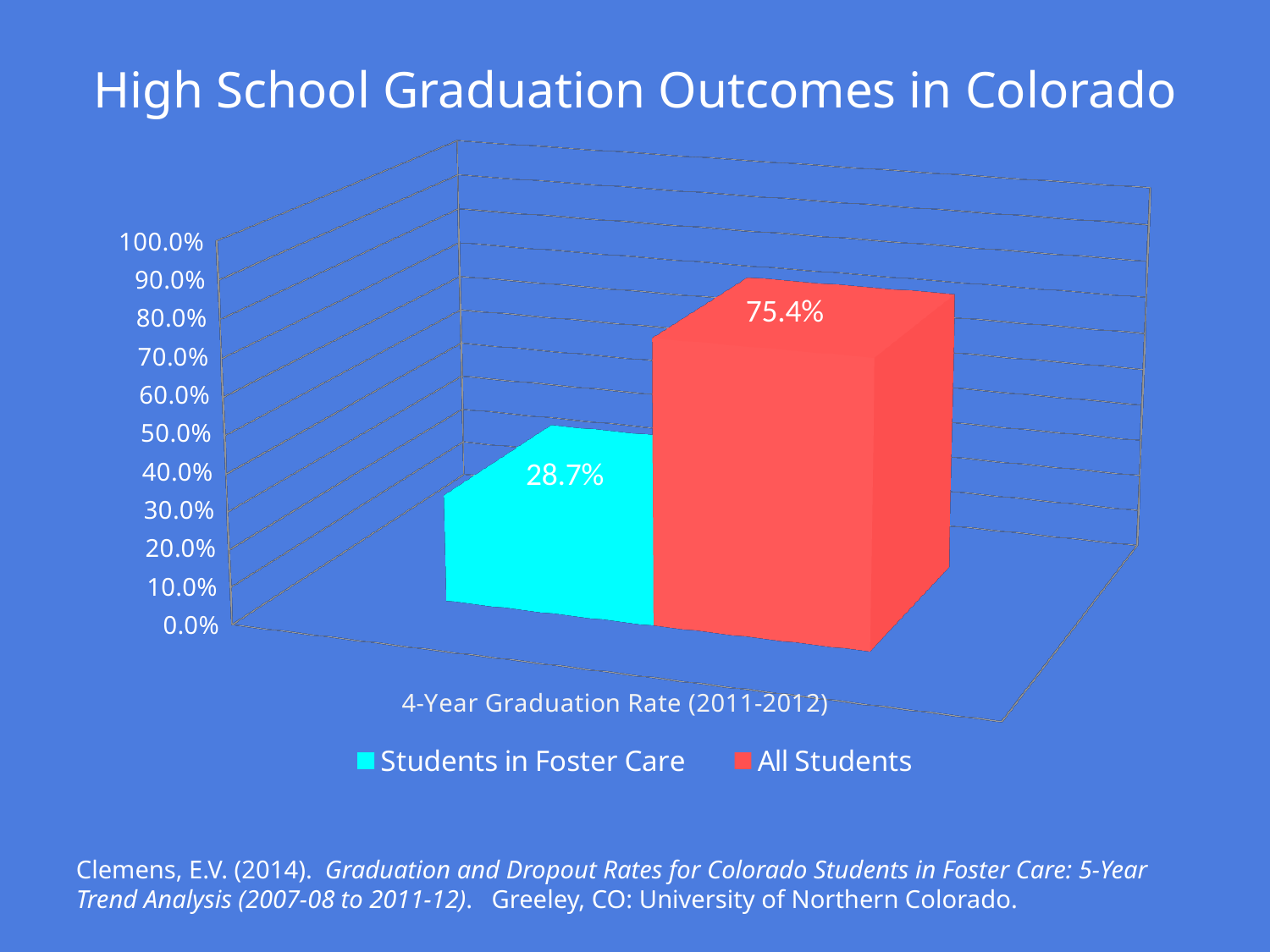
What is the 4-Year Graduation Rate (2011-2012) for Students in Foster Care? 28.7% Which series has the lowest graduation rate shown? Students in Foster Care What is the difference in percentage points between the graduation rate for All Students and for Students in Foster Care? 46.7 percentage points How many series does the legend list? 2 What colour is the bar for All Students? Red Which series has the higher graduation rate, Students in Foster Care or All Students? All Students How many categories are shown on the x axis? 1 What is the 4-Year Graduation Rate (2011-2012) for All Students? 75.4% What kind of chart is shown on the slide? Bar chart Is the graduation rate for Students in Foster Care greater or less than 50.0%? less What is the title of the chart? High School Graduation Outcomes in Colorado Is the graduation rate for All Students greater or less than 70.0%? greater